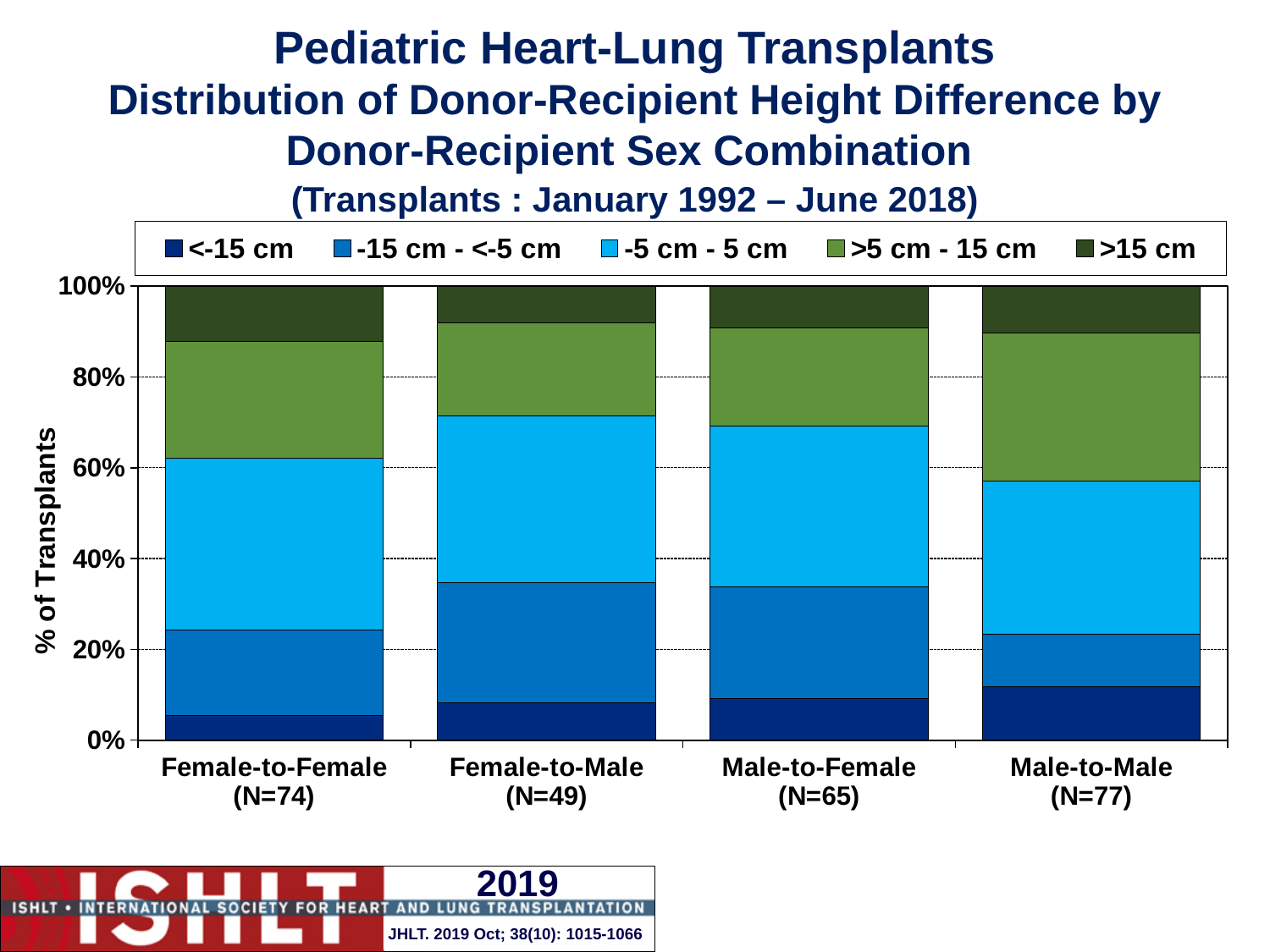
What is the label of the y axis? % of Transplants What is the total of each stacked bar? 100% What is the sample size (N) shown for the Male-to-Male category? N=77 How many height-difference series does the legend list? 5 How many donor-recipient sex combination categories are shown on the x axis? 4 Is the cumulative top of the -5 cm - 5 cm segment for Male-to-Male greater or less than 60%? less Which category has the largest >5 cm - 15 cm segment? Male-to-Male (N=77) What kind of chart is shown on the slide? stacked bar chart Which is larger: the -15 cm - <-5 cm segment for Female-to-Male or for Male-to-Male? Female-to-Male Is the share of the >5 cm - 15 cm segment for Male-to-Male greater or less than 20%? greater Is the share of the <-15 cm segment for Female-to-Female greater or less than 10%? less